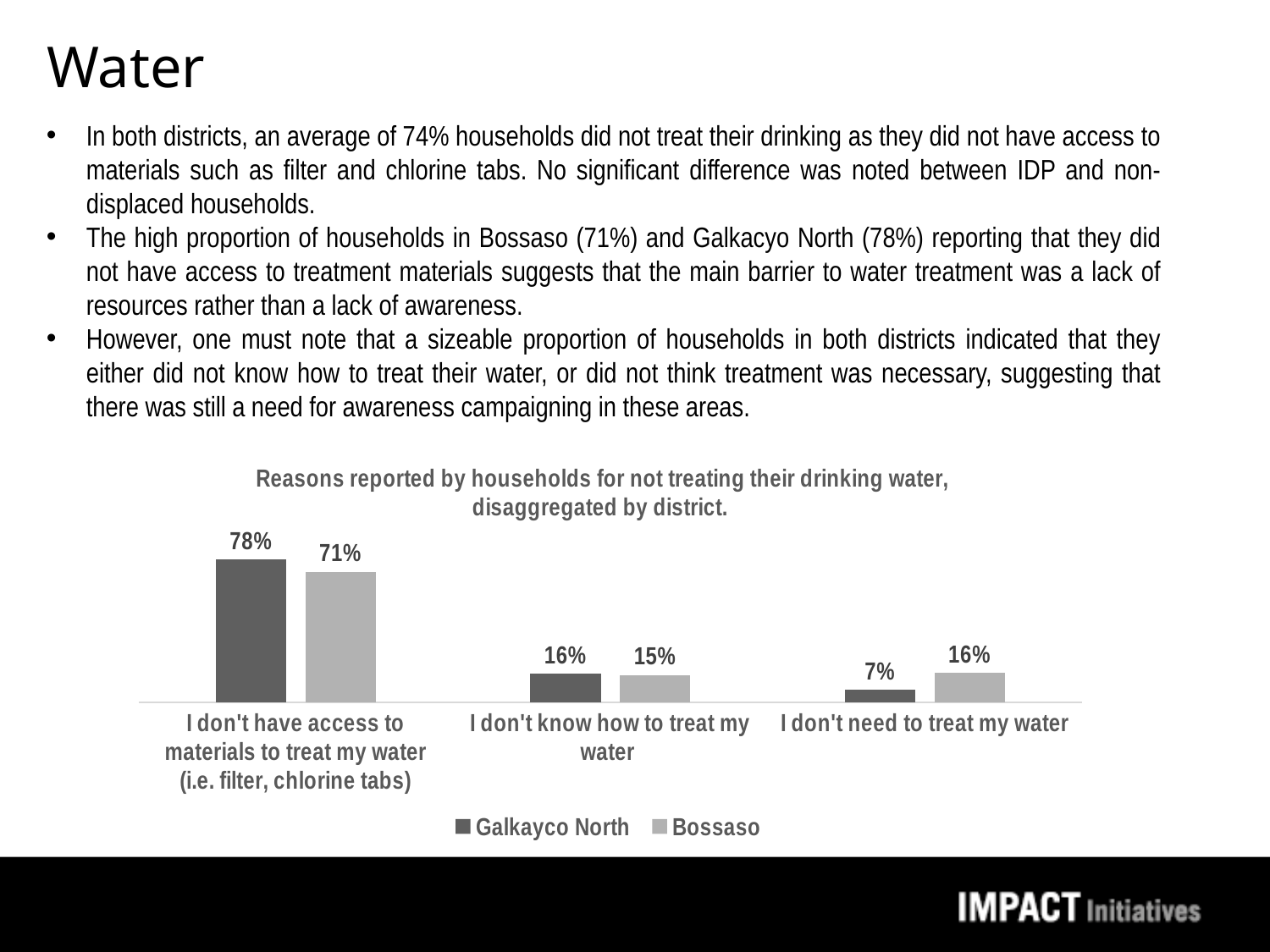
For 'I don't need to treat my water', which district has the larger value? Bossaso What is the difference between Bossaso and Galkayco North for 'I don't need to treat my water'? 9 percentage points Which reason has the lowest value for Galkayco North? I don't need to treat my water How many series does the legend list? 2 Which reason has the highest value for Galkayco North? I don't have access to materials to treat my water (i.e. filter, chlorine tabs) What is the difference between Galkayco North and Bossaso for 'I don't have access to materials to treat my water'? 7 percentage points What kind of chart is shown on the slide? Bar chart What percentage of Bossaso households reported not knowing how to treat their water? 15% What percentage of Bossaso households reported not needing to treat their water? 16% What percentage of Galkayco North households reported not having access to materials to treat their water? 78% How many reason categories are shown on the x axis? 3 For 'I don't have access to materials to treat my water', which district has the larger value? Galkayco North